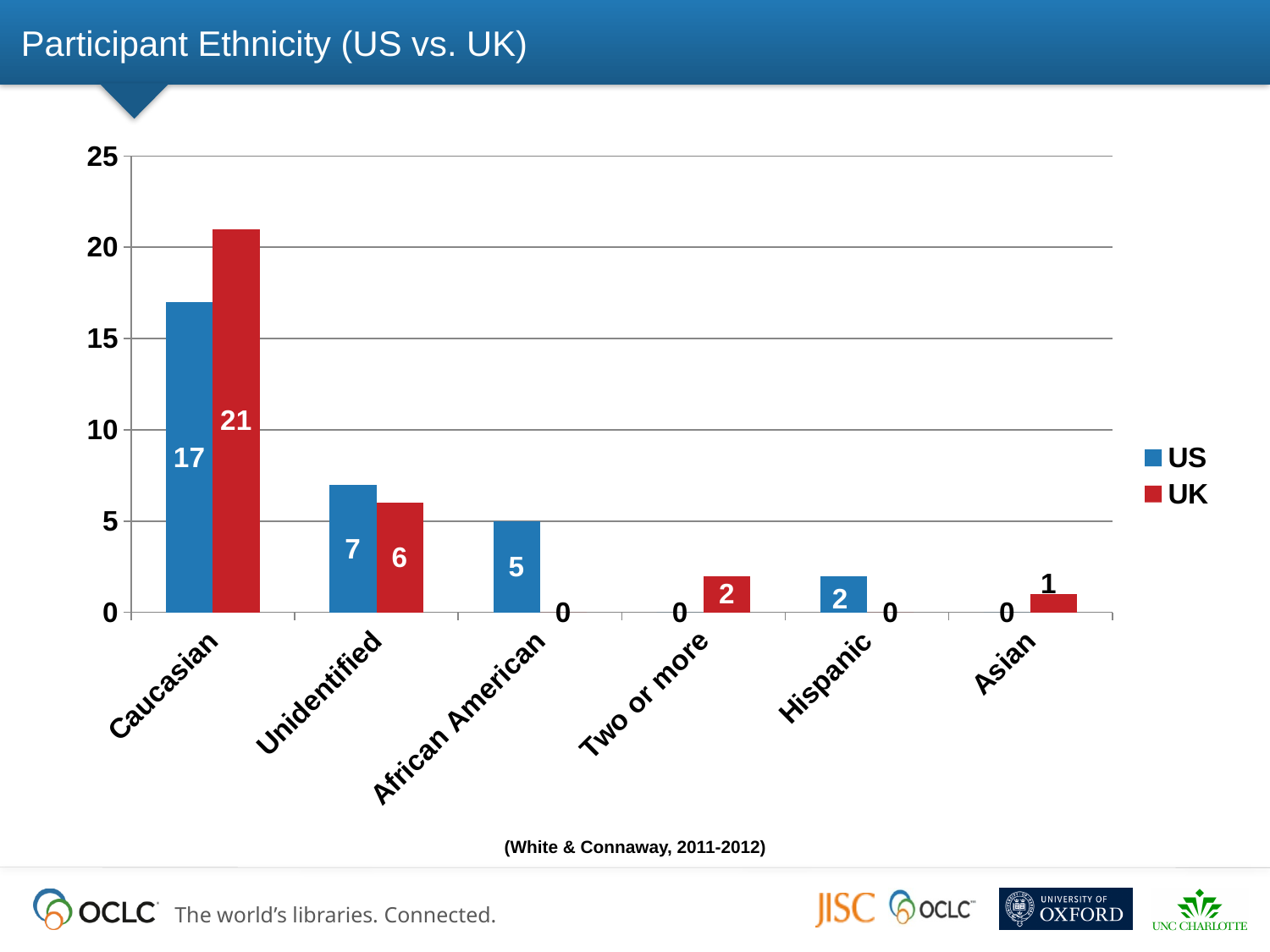
Which is larger for Unidentified, the US value or the UK value? US How many series does the legend list? 2 What is the UK value for Asian? 1 Which category has the highest UK value? Caucasian Is the UK value for Caucasian greater or less than 20? greater What is the US value for African American? 5 How many ethnicity categories are shown on the x axis? 6 What is the difference between the UK and US values for Caucasian? 4 What is the UK value for Caucasian? 21 What is the UK value for Unidentified? 6 What kind of chart is shown on the slide? bar chart What is the US value for Caucasian? 17